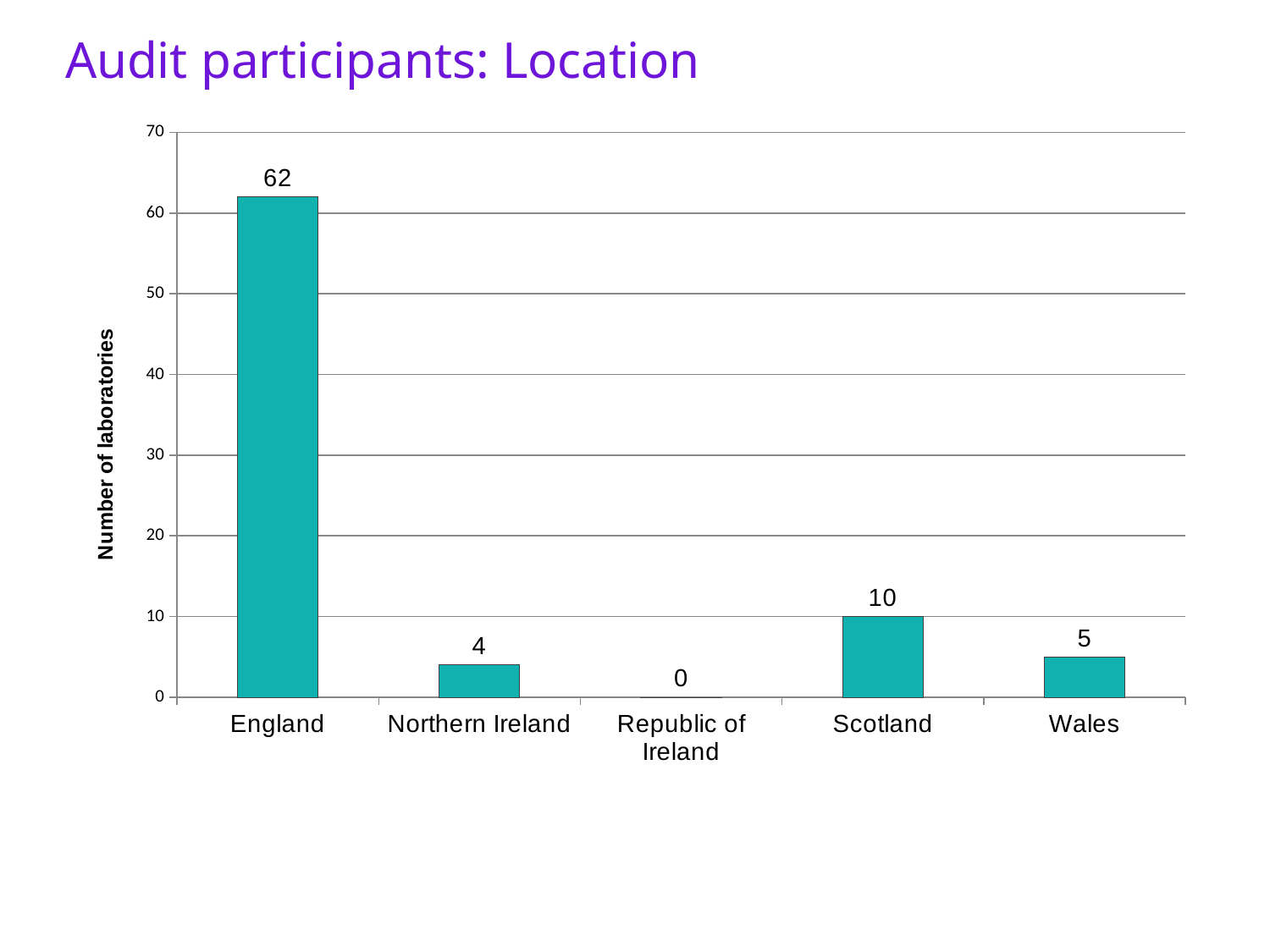
Which location has the highest number of laboratories? England How many laboratories are in the Republic of Ireland? 0 How many laboratories are in Scotland? 10 Which has more laboratories, Scotland or Wales? Scotland What kind of chart is shown on the slide? Bar chart How many laboratories are in England? 62 What is the difference in the number of laboratories between England and Scotland? 52 Which location has the lowest number of laboratories? Republic of Ireland What is the label of the vertical axis? Number of laboratories Is the value for Northern Ireland greater or less than 10? less How many locations are shown on the chart? 5 How many laboratories are in Wales? 5